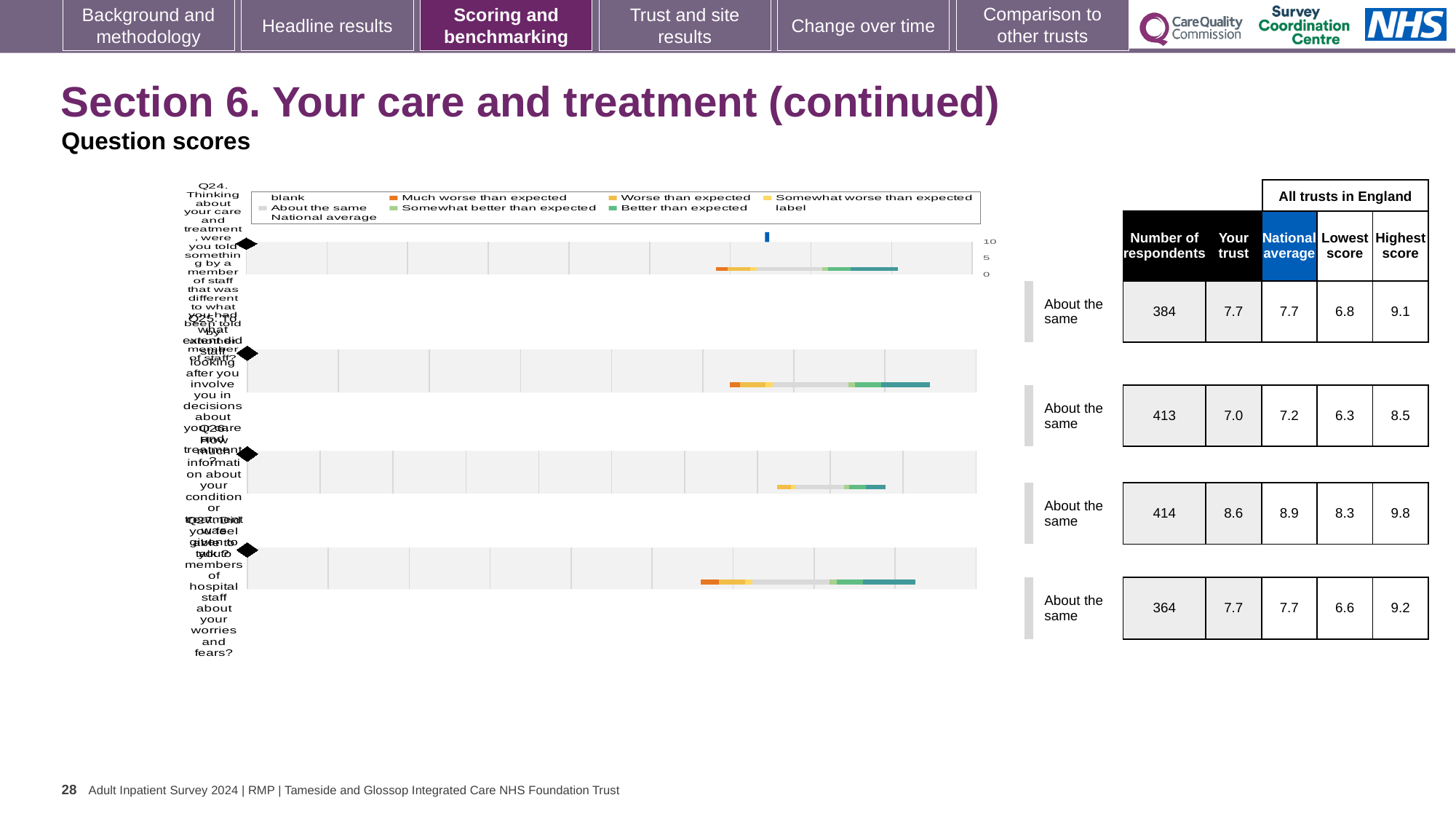
What kind of chart is shown on the slide? bar chart What is the 'Your trust' score for the first (top) question row, Q24? 7.7 Which question row has the highest 'Your trust' score? the third row (8.6) How many question rows are plotted in the chart? 4 What is the national average for the third question row? 8.9 Which question row has the lowest 'Your trust' score? the second row (7.0) Which legend entry is shown in dark orange? Much worse than expected For the second question row, which is larger: the 'Your trust' score or the national average? national average What is the highest score for the fourth (bottom) question row? 9.2 What is the number of respondents for the second question row? 413 How many entries does the chart legend list? 9 What benchmark category is shown for the first (top) question row, Q24? About the same